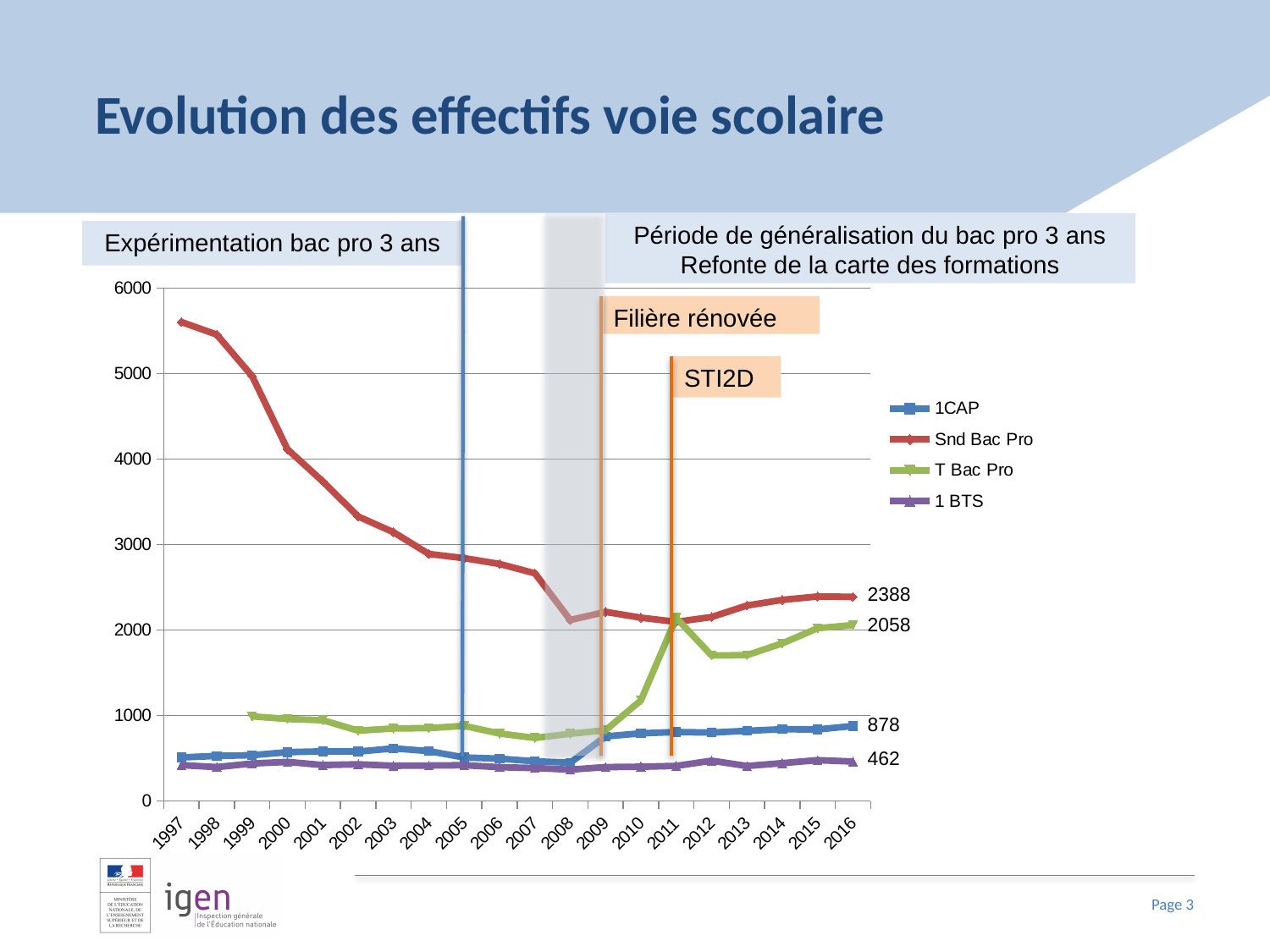
What is the value for Snd Bac Pro in 2016? 2388 How many years are shown on the x axis? 20 Which series has the lowest value in 2016? 1 BTS What is the value for 1CAP in 2016? 878 How many series does the legend list? 4 Which series has the highest value in 2016? Snd Bac Pro Is the value for Snd Bac Pro in 1997 greater or less than 5000? greater What is the value for 1 BTS in 2016? 462 What is the difference between the 2016 values for Snd Bac Pro and T Bac Pro? 330 What kind of chart is shown on the slide? line chart Does the Snd Bac Pro series rise or fall between 1997 and 2008? fall What is the value for T Bac Pro in 2016? 2058